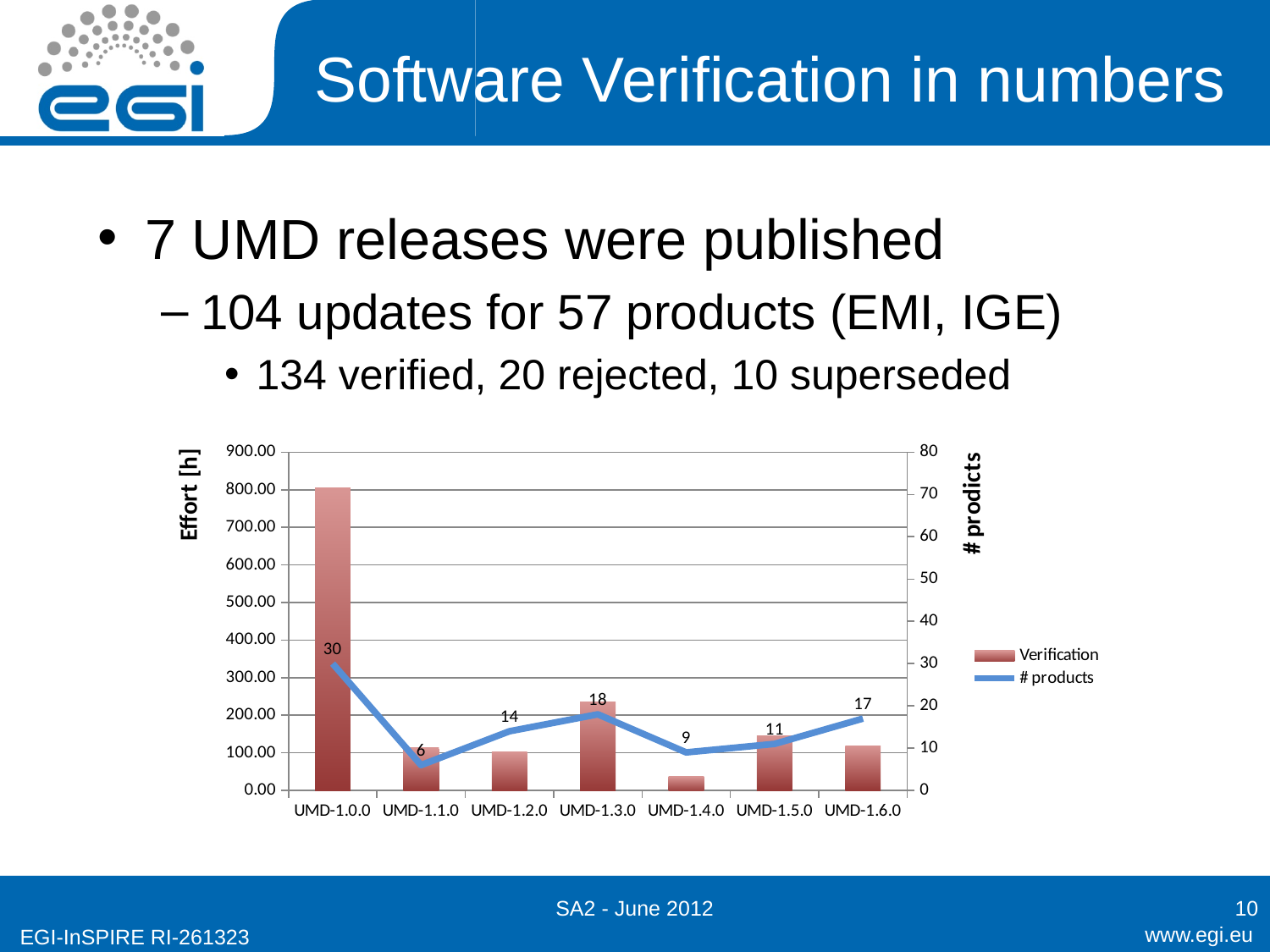
How many series does the legend list? 2 Which UMD release has the highest # products value? UMD-1.0.0 What is the difference in # products between UMD-1.0.0 and UMD-1.1.0? 24 How many products (# products) were verified for UMD-1.0.0? 30 What is the # products value for UMD-1.3.0? 18 Which UMD release has the lowest # products value? UMD-1.1.0 What is the title of the left vertical axis? Effort [h] How many UMD releases are shown on the x axis? 7 Which has more products, UMD-1.5.0 or UMD-1.4.0? UMD-1.5.0 What is the # products value for UMD-1.6.0? 17 Which UMD release has the lowest Verification effort bar? UMD-1.4.0 Is the Verification effort for UMD-1.0.0 greater or less than 700.00? greater